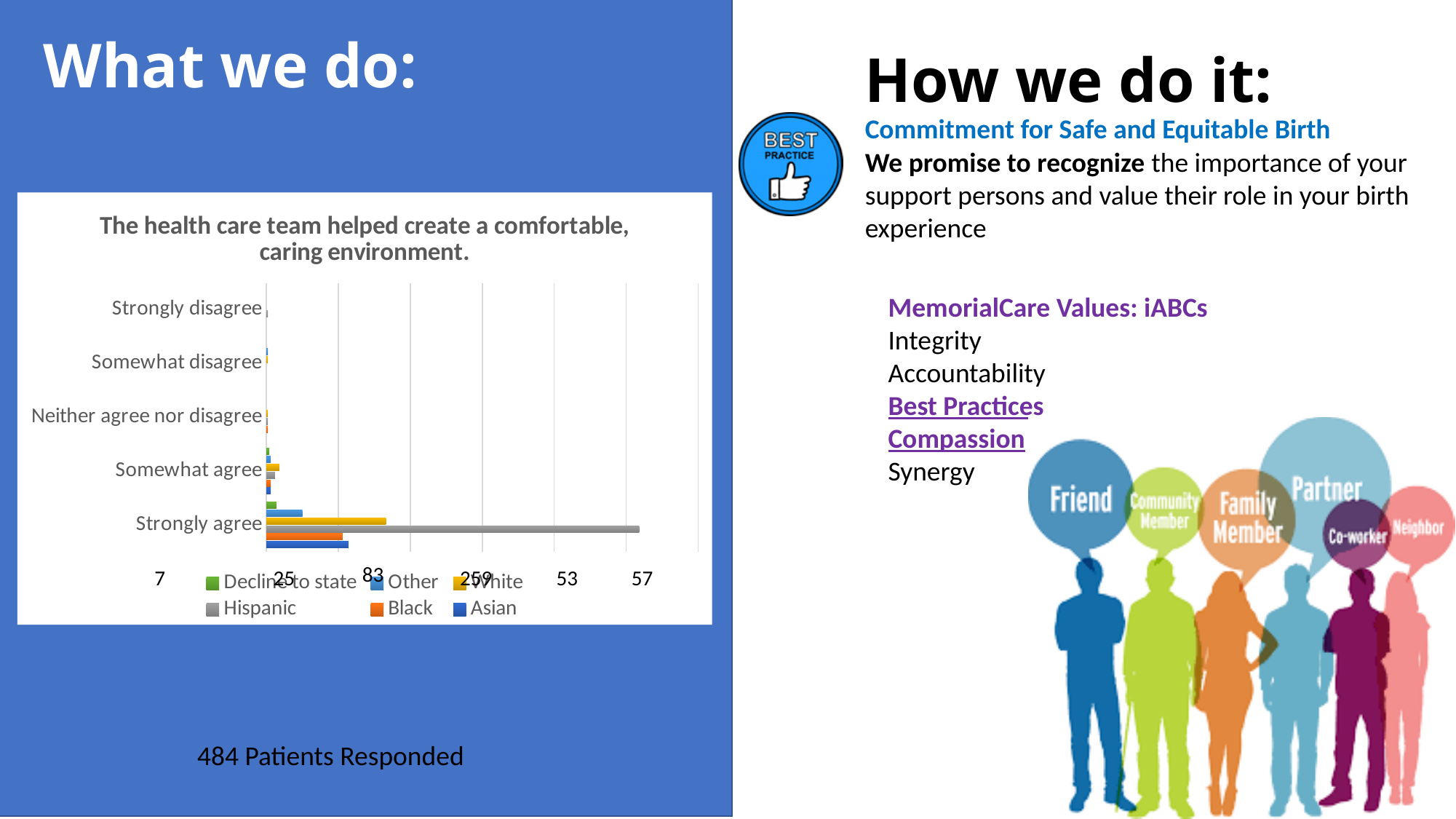
In the Strongly agree category, which bar is longer: White or Other? White What colour represents the Hispanic series in the chart? Gray In the Strongly agree category, which bar is shorter: Decline to state or Other? Decline to state Which response category has the shortest bars overall? Strongly disagree What kind of chart is shown on the slide? Bar chart Which response category has the longest bars overall? Strongly agree Which series has the longest bar in the Strongly agree category? Hispanic What is the title of the chart? The health care team helped create a comfortable, caring environment. How many response categories are shown on the chart's vertical axis? 5 How many series does the chart's legend list? 6 In the Strongly agree category, which bar is longer: Hispanic or White? Hispanic